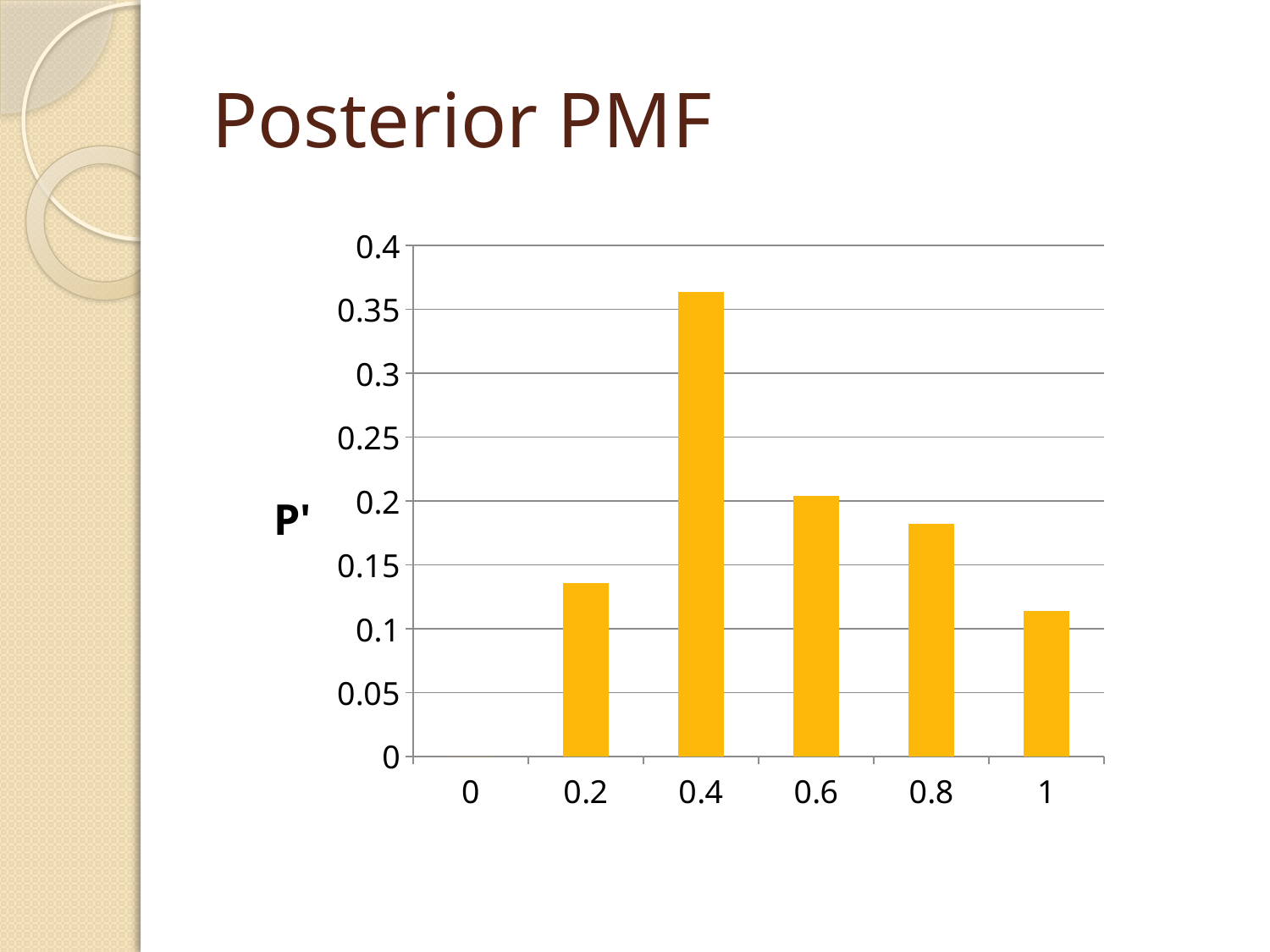
Among the categories 0.2, 0.4, 0.6, 0.8 and 1, which has the lowest bar? 1 Is the value for 0.6 greater or less than 0.25? less What kind of chart is shown on the slide? bar chart Is the value for 0.2 greater or less than 0.15? less Is the value for 0.8 greater or less than 0.2? less What is the title of the slide containing the chart? Posterior PMF Which category has the highest bar in the chart? 0.4 How many categories are shown on the x axis of the chart? 6 What is the label on the y axis of the chart? P' Which has the larger value, 0.6 or 0.8? 0.6 Do the bar values rise or fall from 0.4 to 1 along the x axis? fall